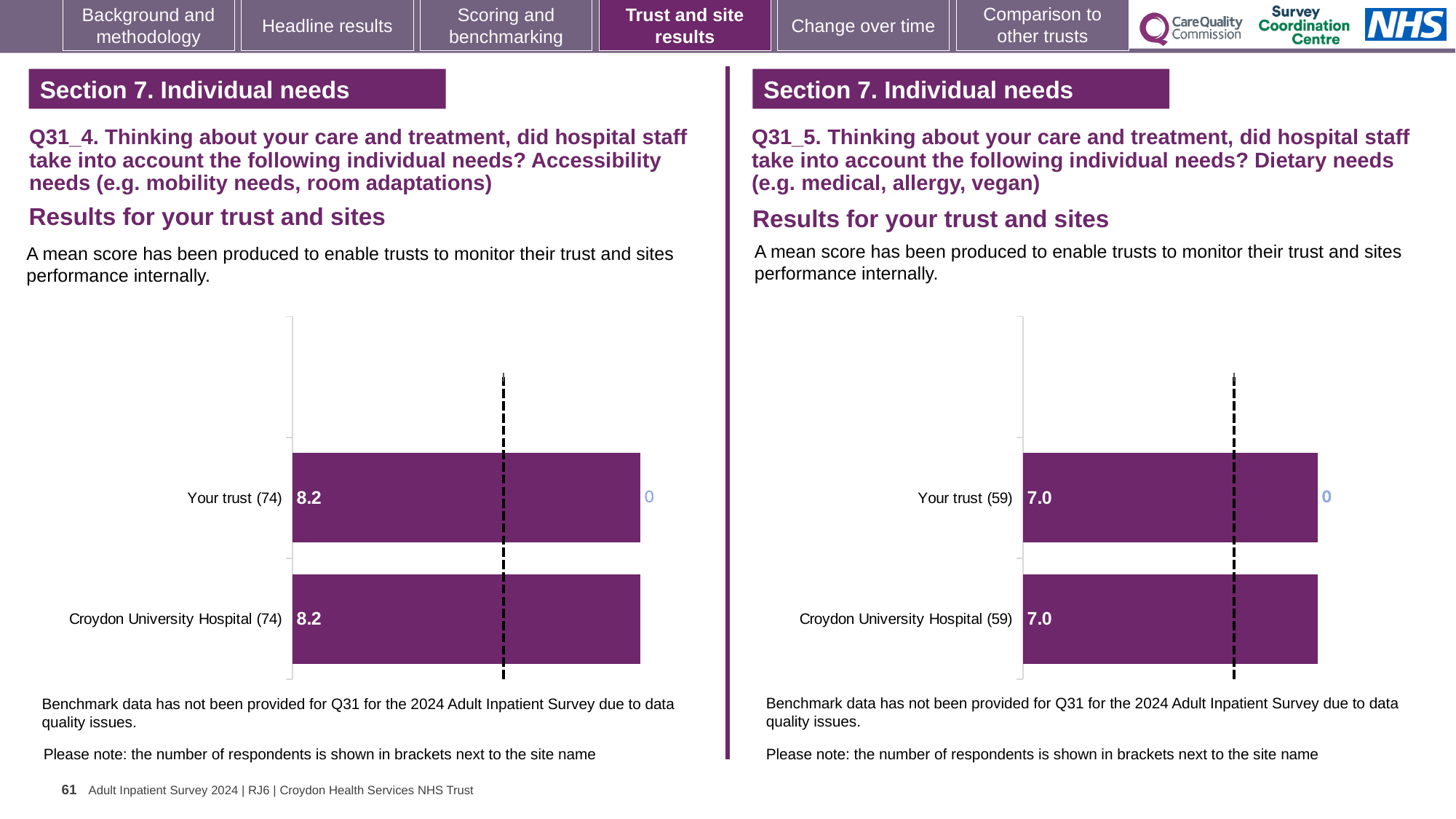
In the Q31_4 chart on the left, how many respondents are shown in brackets next to Your trust? 74 What type of chart is used in the Q31_4 chart on the left? Bar chart In the Q31_5 chart on the right (Dietary needs), what is the mean score for Your trust? 7.0 In the Q31_4 chart on the left (Accessibility needs), what is the mean score for Your trust? 8.2 Is the mean score for Your trust in the Q31_5 chart on the right higher or lower than the mean score for Your trust in the Q31_4 chart on the left? Lower In the Q31_4 chart on the left, what is the difference between the mean score for Your trust and the mean score for Croydon University Hospital? 0.0 In the Q31_4 chart on the left (Accessibility needs), what is the mean score for Croydon University Hospital? 8.2 In the Q31_5 chart on the right, how many categories are shown? 2 What type of chart is used in the Q31_5 chart on the right? Bar chart In the Q31_5 chart on the right, how many respondents are shown in brackets next to Croydon University Hospital? 59 In the Q31_4 chart on the left, how many bars are plotted? 2 In the Q31_5 chart on the right (Dietary needs), what is the mean score for Croydon University Hospital? 7.0